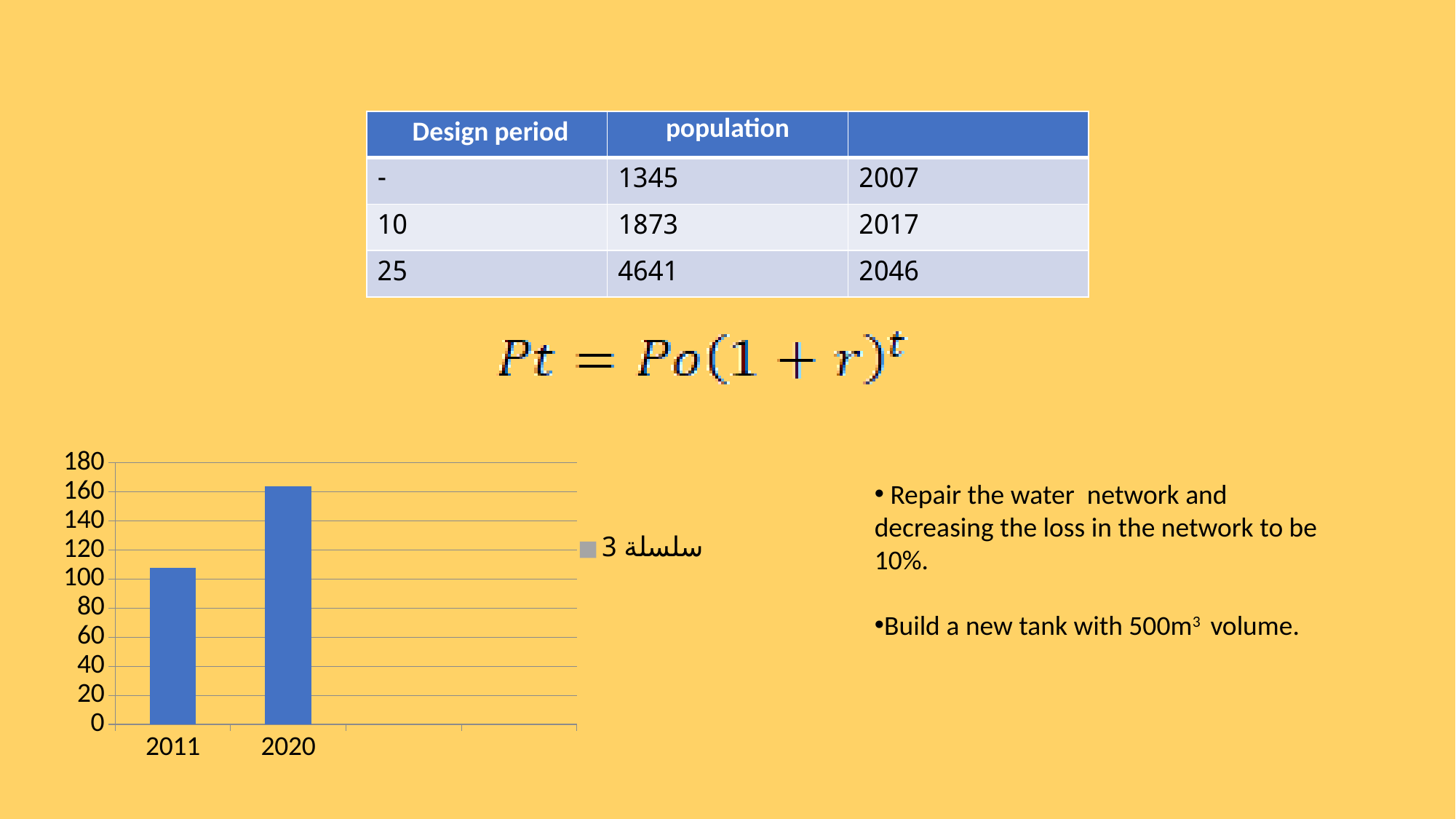
Do the values rise or fall from 2011 to 2020? rise Is the value for 2011 greater or less than 120? less Is the value for 2020 greater or less than 180? less Is the value for 2020 greater or less than 160? greater What is the highest value shown on the chart's vertical axis? 180 Which year has the lowest bar in the chart? 2011 Which bar is taller, 2011 or 2020? 2020 How many bars are plotted in the chart? 2 What kind of chart is shown on the slide? bar chart Which year has the highest bar in the chart? 2020 How many series does the chart legend list? 1